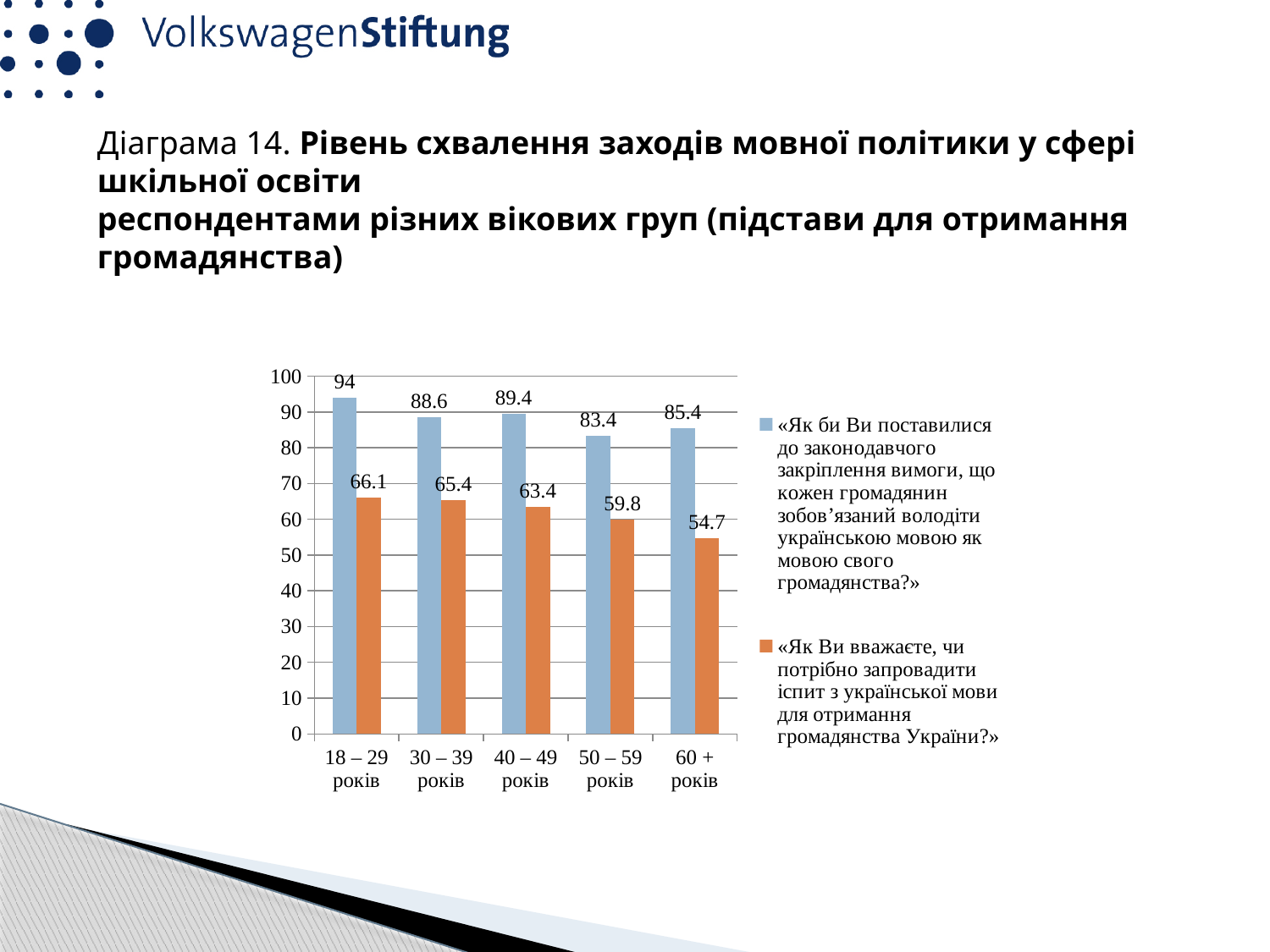
What is the value of the orange series (Ukrainian language exam for citizenship) for the 40 – 49 років group? 63.4 Which age group has the lowest value in the orange series (Ukrainian language exam for citizenship)? 60 + років Does the orange series (Ukrainian language exam for citizenship) rise or fall as age groups increase along the x axis? fall What is the value of the orange series (Ukrainian language exam for citizenship) for the 60 + років group? 54.7 How many series does the chart's legend list? 2 What is the difference between the blue and orange series values for the 50 – 59 років group? 23.6 What colour are the bars for the series about introducing a Ukrainian language exam for obtaining citizenship? orange How many age groups are shown on the x axis of the chart? 5 What is the value of the blue series (legislative requirement to know Ukrainian) for the 18 – 29 років group? 94 Which age group has the highest value in the blue series (legislative requirement to know Ukrainian)? 18 – 29 років Which is larger: the blue series value for 30 – 39 років or the blue series value for 40 – 49 років? 40 – 49 років What type of chart is shown on the slide? bar chart